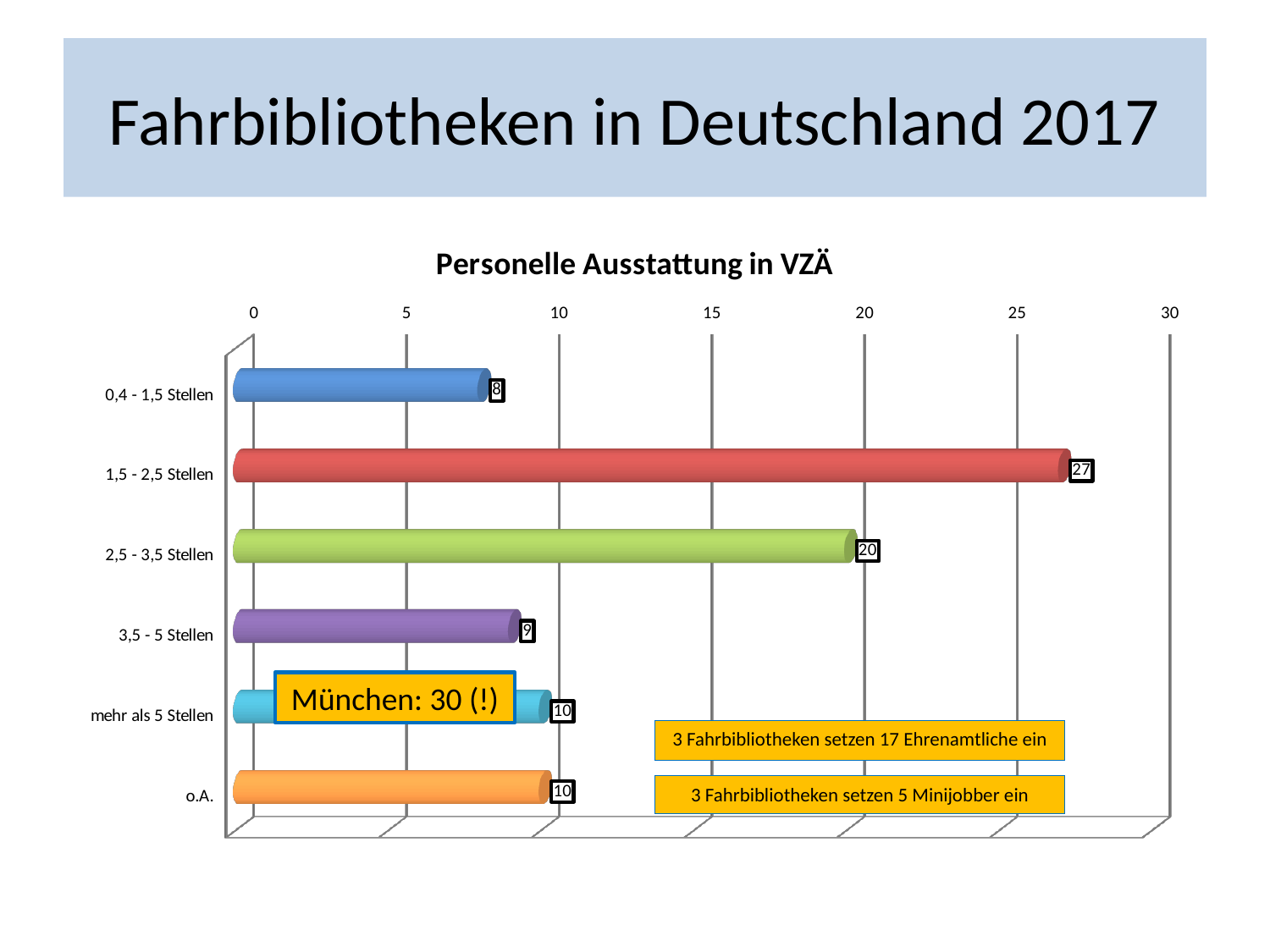
What kind of chart is shown on the slide? Bar chart What is the value for the category "o.A."? 10 Which category has the highest value? 1,5 - 2,5 Stellen Is the value for "2,5 - 3,5 Stellen" greater or less than 15? greater What is the difference between the values for "1,5 - 2,5 Stellen" and "2,5 - 3,5 Stellen"? 7 Which is larger, the value for "3,5 - 5 Stellen" or the value for "mehr als 5 Stellen"? mehr als 5 Stellen How many categories are shown in the chart? 6 Which category has the lowest value? 0,4 - 1,5 Stellen What is the title of the chart? Personelle Ausstattung in VZÄ What is the value for the category "0,4 - 1,5 Stellen"? 8 What is the value for the category "1,5 - 2,5 Stellen"? 27 What is the value for the category "2,5 - 3,5 Stellen"? 20